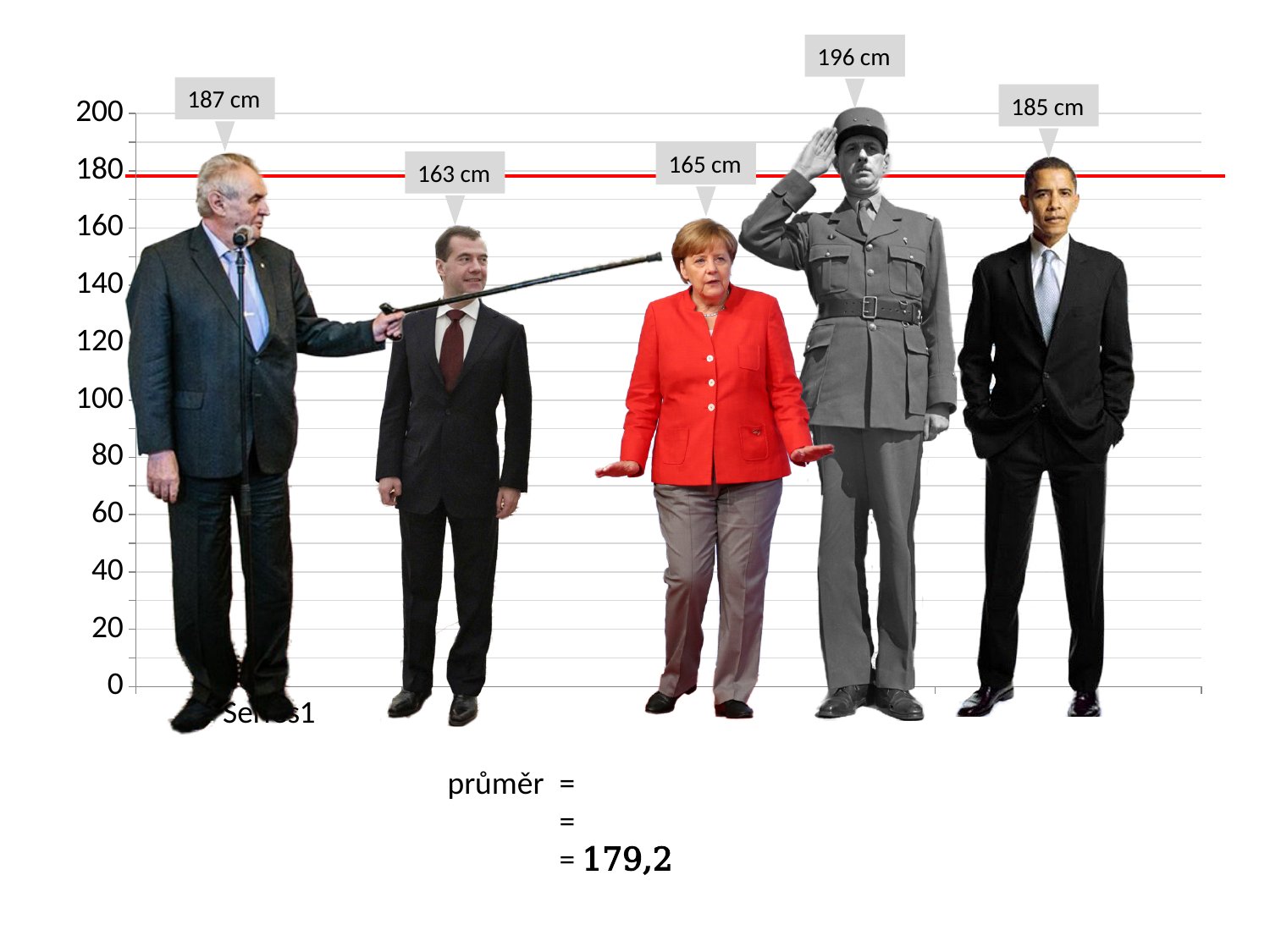
How many figures (categories) are plotted in the chart? 5 Which figure has the highest value in the chart? The fourth from the left (196 cm) What is the difference between the highest value (196 cm) and the lowest value (163 cm)? 33 cm What is the value shown for the third figure from the left (the one in red)? 165 cm What is the difference between the first figure's value (187 cm) and the fifth figure's value (185 cm)? 2 cm Which figure has the lowest value in the chart? The second from the left (163 cm) What is the value shown for the fourth figure from the left (the one in uniform)? 196 cm What is the value shown for the second figure from the left in the chart? 163 cm What is the value shown for the fifth (rightmost) figure in the chart? 185 cm What is the value shown for the first (leftmost) figure in the chart? 187 cm What average (průměr) value is printed below the chart? 179,2 Which is larger, the value for the second figure or the value for the third figure? The third figure (165 cm)